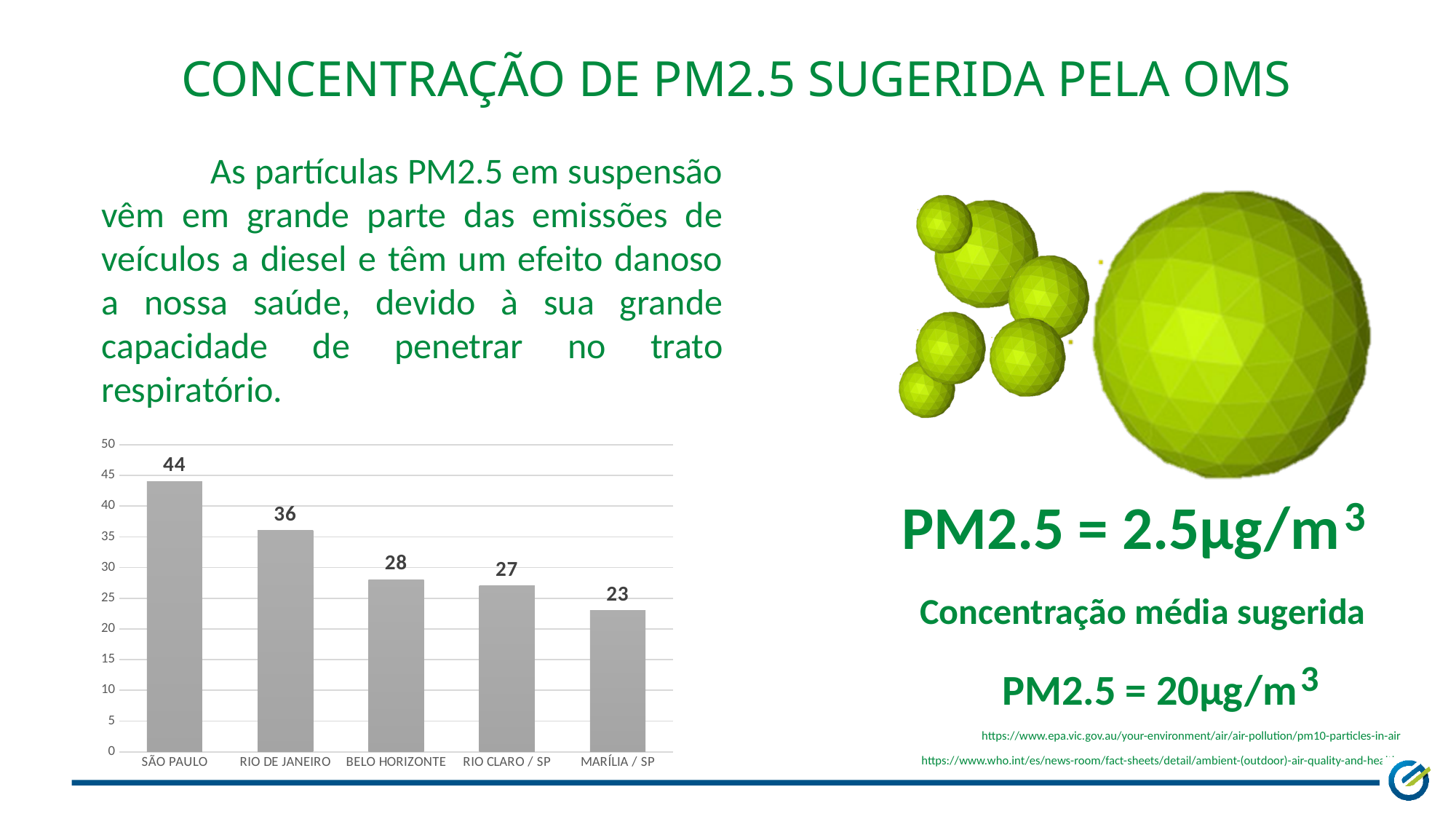
How many categories are shown in the chart? 5 Which is larger, the value for RIO DE JANEIRO or the value for RIO CLARO / SP? RIO DE JANEIRO What kind of chart is shown on the slide? bar chart What is the value for SÃO PAULO? 44 What is the value for BELO HORIZONTE? 28 What is the difference between the values for SÃO PAULO and RIO DE JANEIRO? 8 What is the value for RIO DE JANEIRO? 36 What is the value for MARÍLIA / SP? 23 Do the values rise or fall from left to right along the x axis? fall Which category has the highest value? SÃO PAULO Which category has the lowest value? MARÍLIA / SP Is the value for BELO HORIZONTE greater or less than 25? greater